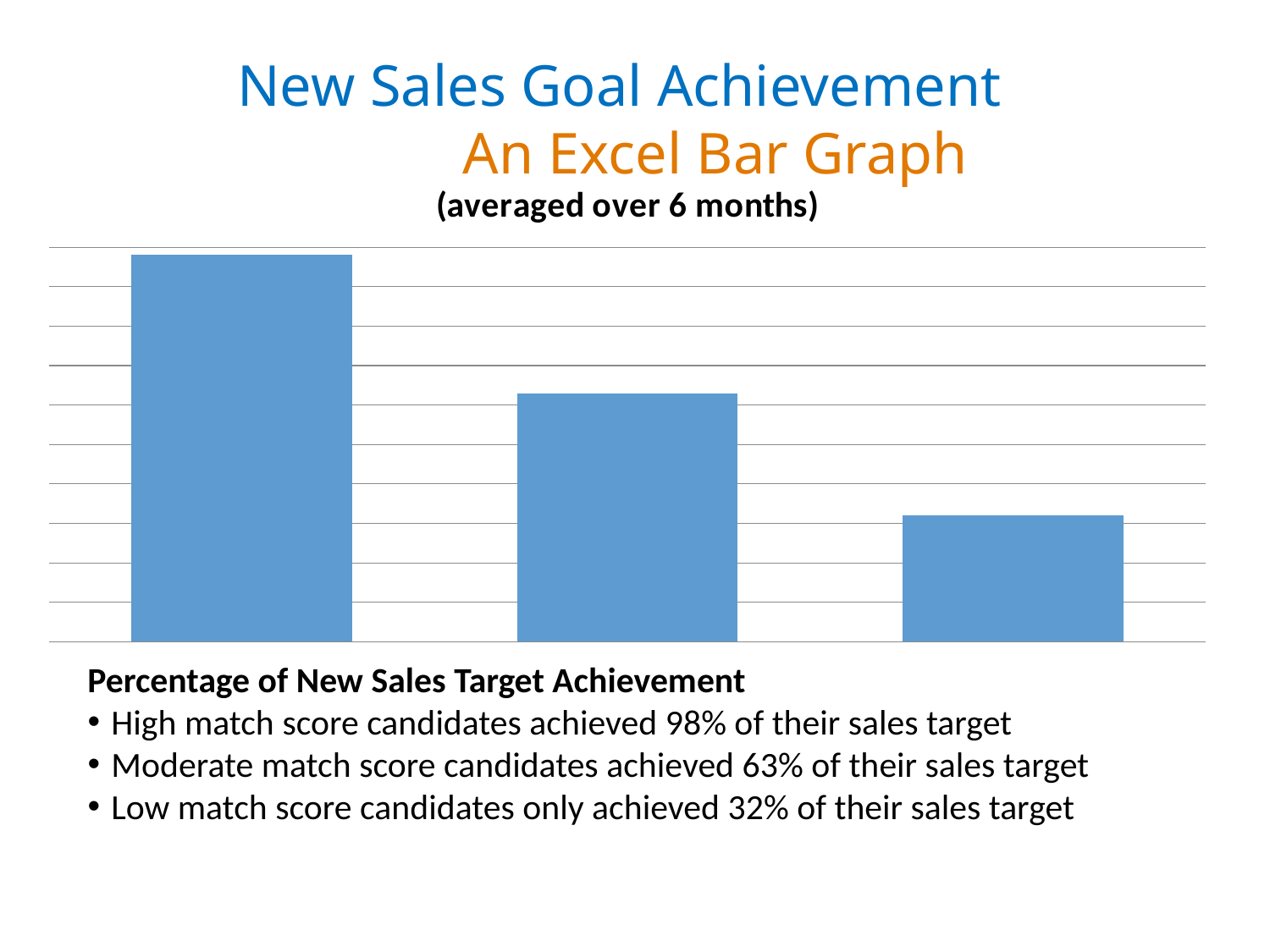
Which bar is the shortest in the chart: the left, middle, or right bar? right Which bar is the tallest in the chart: the left, middle, or right bar? left What kind of chart is shown on the slide? bar chart What is the main title shown above the chart? New Sales Goal Achievement Do the bar heights rise or fall from left to right across the chart? fall Over what period are the chart values averaged, according to the subtitle? 6 months Is the right bar taller or shorter than the middle bar? shorter How many bars are plotted in the chart? 3 Is the left bar taller or shorter than the middle bar? taller